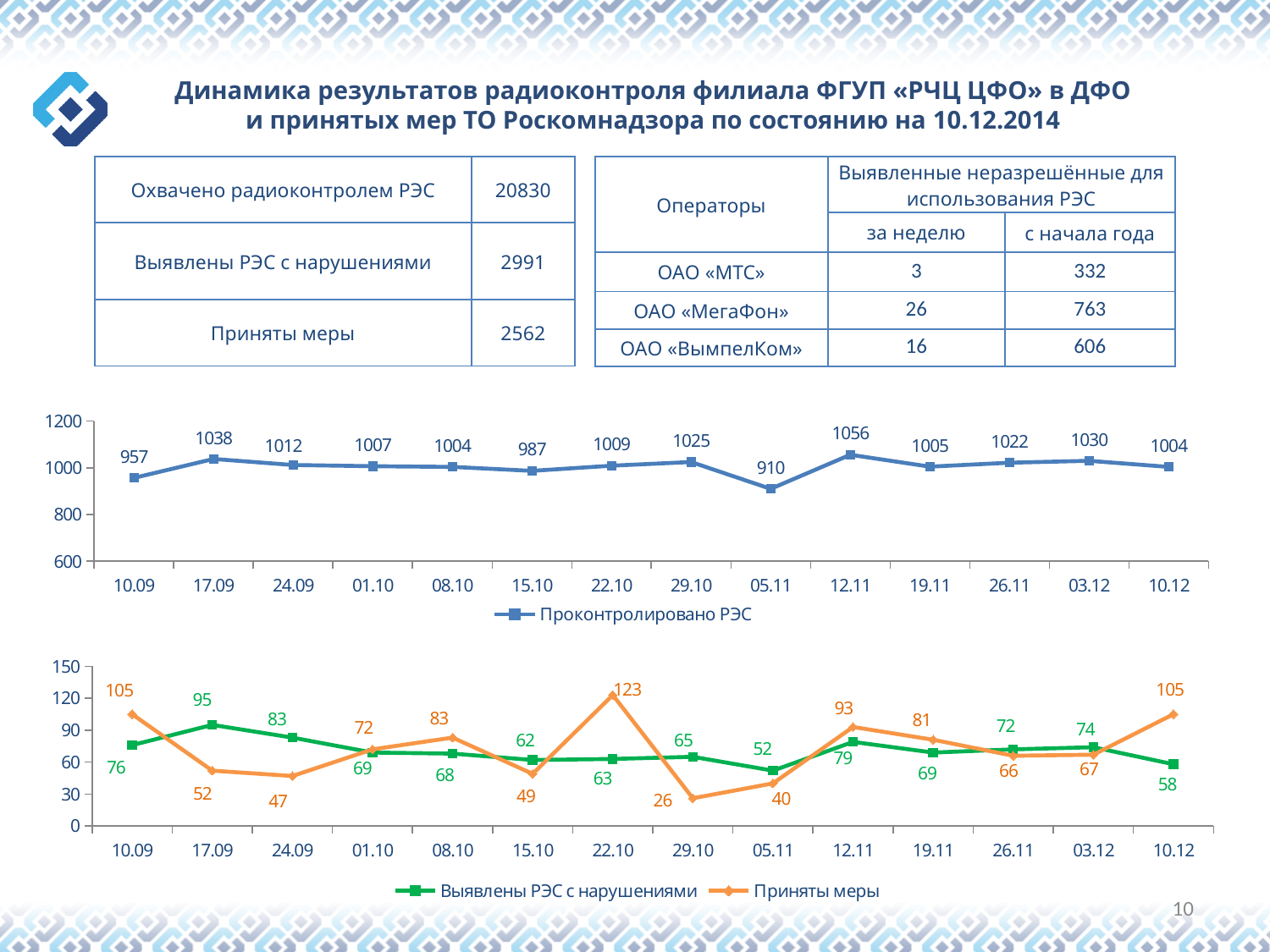
How many data points are plotted in the top chart (Проконтролировано РЭС)? 14 In the bottom chart, what is the value of Приняты меры for 22.10? 123 How many series does the legend of the bottom chart list? 2 In the top chart (Проконтролировано РЭС), what is the difference between the values for 17.09 and 10.09? 81 In the bottom chart, what is the difference between Приняты меры and Выявлены РЭС с нарушениями for 10.12? 47 In the bottom chart, which date has the lowest value for Приняты меры? 29.10 In the top chart (Проконтролировано РЭС), which date has the highest value? 12.11 In the top chart (Проконтролировано РЭС), what is the value for 05.11? 910 In the bottom chart, what is the value of Выявлены РЭС с нарушениями for 17.09? 95 In the bottom chart, which is larger for 12.11: Выявлены РЭС с нарушениями or Приняты меры? Приняты меры What type of chart is the top chart (Проконтролировано РЭС)? Line chart In the top chart (Проконтролировано РЭС), which date has the lowest value? 05.11